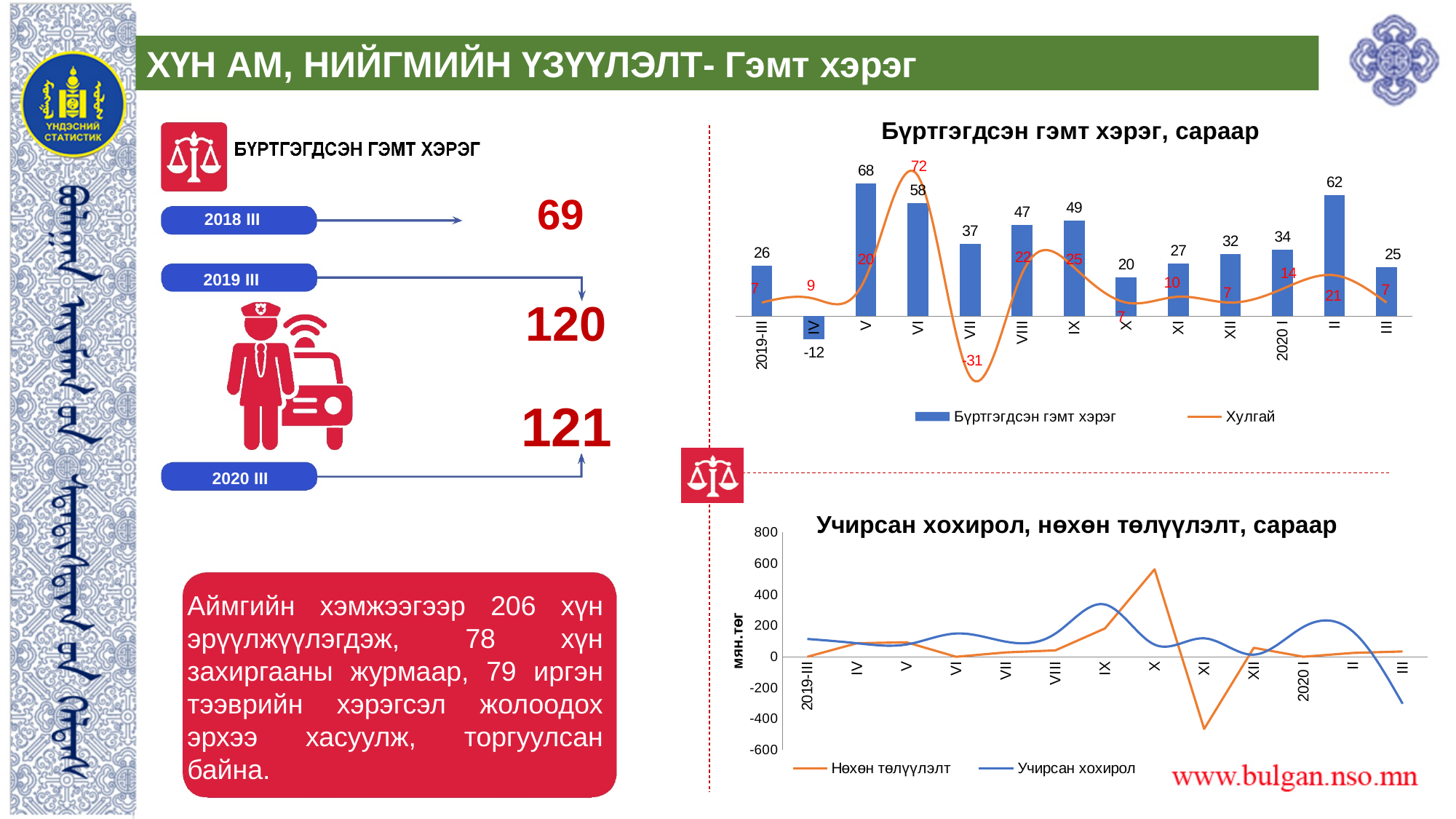
How many bars are plotted in the chart 'Бүртгэгдсэн гэмт хэрэг, сараар'? 13 In the chart 'Бүртгэгдсэн гэмт хэрэг, сараар', what is the Хулгай value for VI? 72 In the chart 'Бүртгэгдсэн гэмт хэрэг, сараар', which month has the highest bar value? V In the chart 'Бүртгэгдсэн гэмт хэрэг, сараар', what is the Хулгай value for VII? -31 In the chart 'Бүртгэгдсэн гэмт хэрэг, сараар', which month has the lowest bar value? IV How many series does the legend of the chart 'Учирсан хохирол, нөхөн төлүүлэлт, сараар' list? 2 In the chart 'Бүртгэгдсэн гэмт хэрэг, сараар', what is the value of the bar for V? 68 In the chart 'Бүртгэгдсэн гэмт хэрэг, сараар', what is the difference between the bar values for V and VI? 10 In the chart 'Учирсан хохирол, нөхөн төлүүлэлт, сараар', is the Учирсан хохирол value for 2020 III greater or less than -200? less In the chart 'Бүртгэгдсэн гэмт хэрэг, сараар', which is larger: the bar value for VIII or for IX? IX In the chart 'Бүртгэгдсэн гэмт хэрэг, сараар', what is the value of the bar for 2020 II? 62 In the chart 'Учирсан хохирол, нөхөн төлүүлэлт, сараар', is the Нөхөн төлүүлэлт value for X greater or less than 400? greater